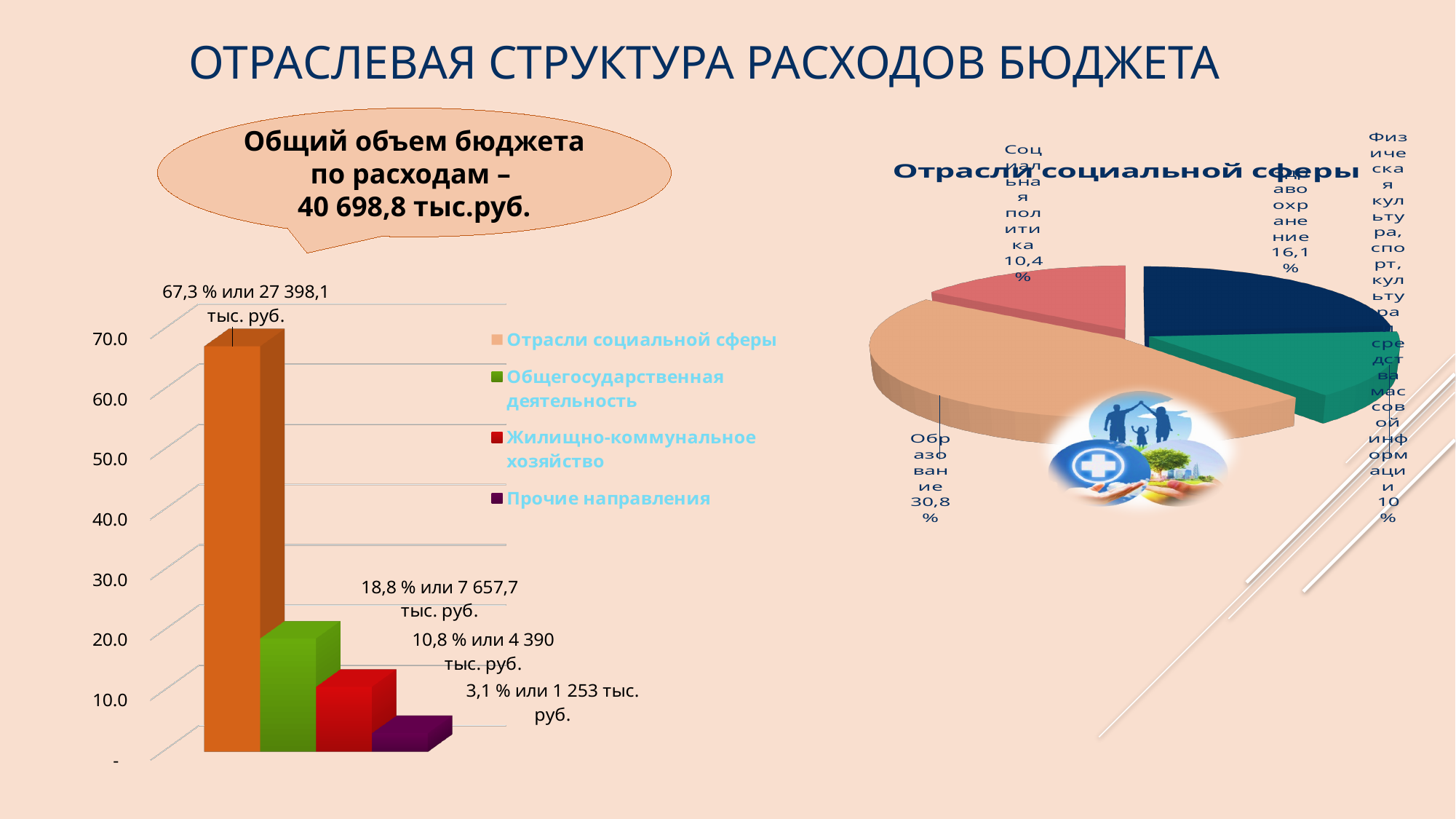
What kind of chart is the chart on the left side of the slide? bar chart What kind of chart is the chart titled "Отрасли социальной сферы"? pie chart In the bar chart on the left, what is the difference in percentage points between Отрасли социальной сферы and Общегосударственная деятельность? 48,5 % In the bar chart on the left, what value is labelled for Жилищно-коммунальное хозяйство? 10,8 % или 4 390 тыс. руб. In the bar chart on the left, what value is labelled for Отрасли социальной сферы? 67,3 % или 27 398,1 тыс. руб. In the bar chart on the left, which category has the lowest value? Прочие направления In the bar chart on the left, how many entries does the legend list? 4 In the pie chart "Отрасли социальной сферы", what percentage is shown for Здравоохранение? 16,1 % In the bar chart on the left, is the value for Отрасли социальной сферы greater or less than 60? greater In the bar chart on the left, which category has the highest value? Отрасли социальной сферы In the pie chart "Отрасли социальной сферы", which is larger: Здравоохранение or Социальная политика? Здравоохранение In the pie chart "Отрасли социальной сферы", which slice has the largest labelled percentage? Образование